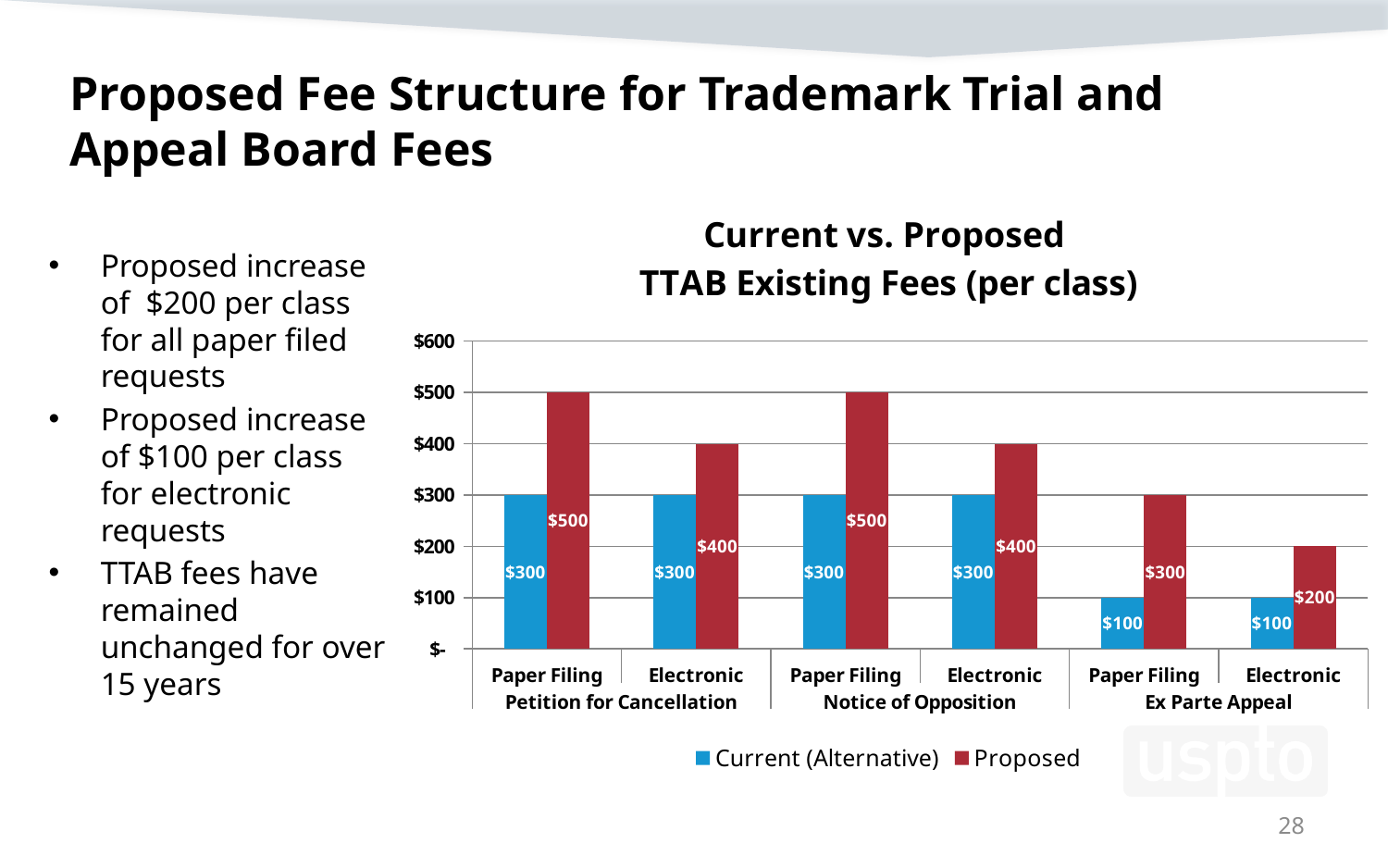
What is the difference between the Proposed and Current (Alternative) fees for Paper Filing under Notice of Opposition? $200 Which is larger: the Proposed fee for Paper Filing under Ex Parte Appeal or the Current (Alternative) fee for Paper Filing under Petition for Cancellation? They are equal ($300) How many filing categories are shown on the x axis? 6 What is the Proposed fee for Electronic filing under Notice of Opposition? $400 What kind of chart is shown on the slide? Bar chart Is the Proposed fee for Paper Filing under Petition for Cancellation greater or less than $400? greater How many series does the legend list? 2 What colour represents the Proposed series in the chart? Red What is the Current (Alternative) fee for Electronic filing under Ex Parte Appeal? $100 Which category has the lowest Proposed fee? Electronic, Ex Parte Appeal What is the difference between the Proposed and Current (Alternative) fees for Electronic filing under Petition for Cancellation? $100 What is the Proposed fee for Paper Filing under Petition for Cancellation? $500